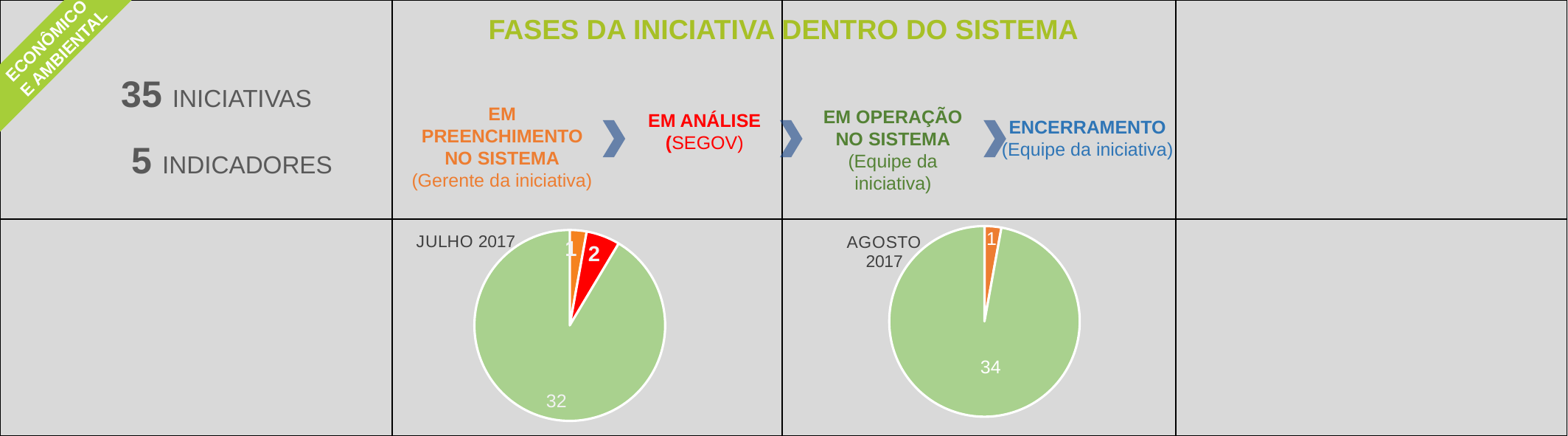
In the JULHO 2017 pie chart, which slice is the largest? the green slice (32) In the AGOSTO 2017 pie chart, what is the value of the orange slice? 1 How many slices does the AGOSTO 2017 pie chart have? 2 In the AGOSTO 2017 pie chart, what is the value of the green slice? 34 What is the total of all slices in the AGOSTO 2017 pie chart? 35 In the JULHO 2017 pie chart, what is the value of the orange slice? 1 In the JULHO 2017 pie chart, what is the value of the red slice? 2 How many slices does the JULHO 2017 pie chart have? 3 In the JULHO 2017 pie chart, what is the value of the green slice? 32 In the JULHO 2017 pie chart, what is the difference between the green slice and the red slice? 30 Which is larger: the green slice in the JULHO 2017 chart or the green slice in the AGOSTO 2017 chart? the green slice in the AGOSTO 2017 chart (34) What kind of chart is the JULHO 2017 chart? pie chart